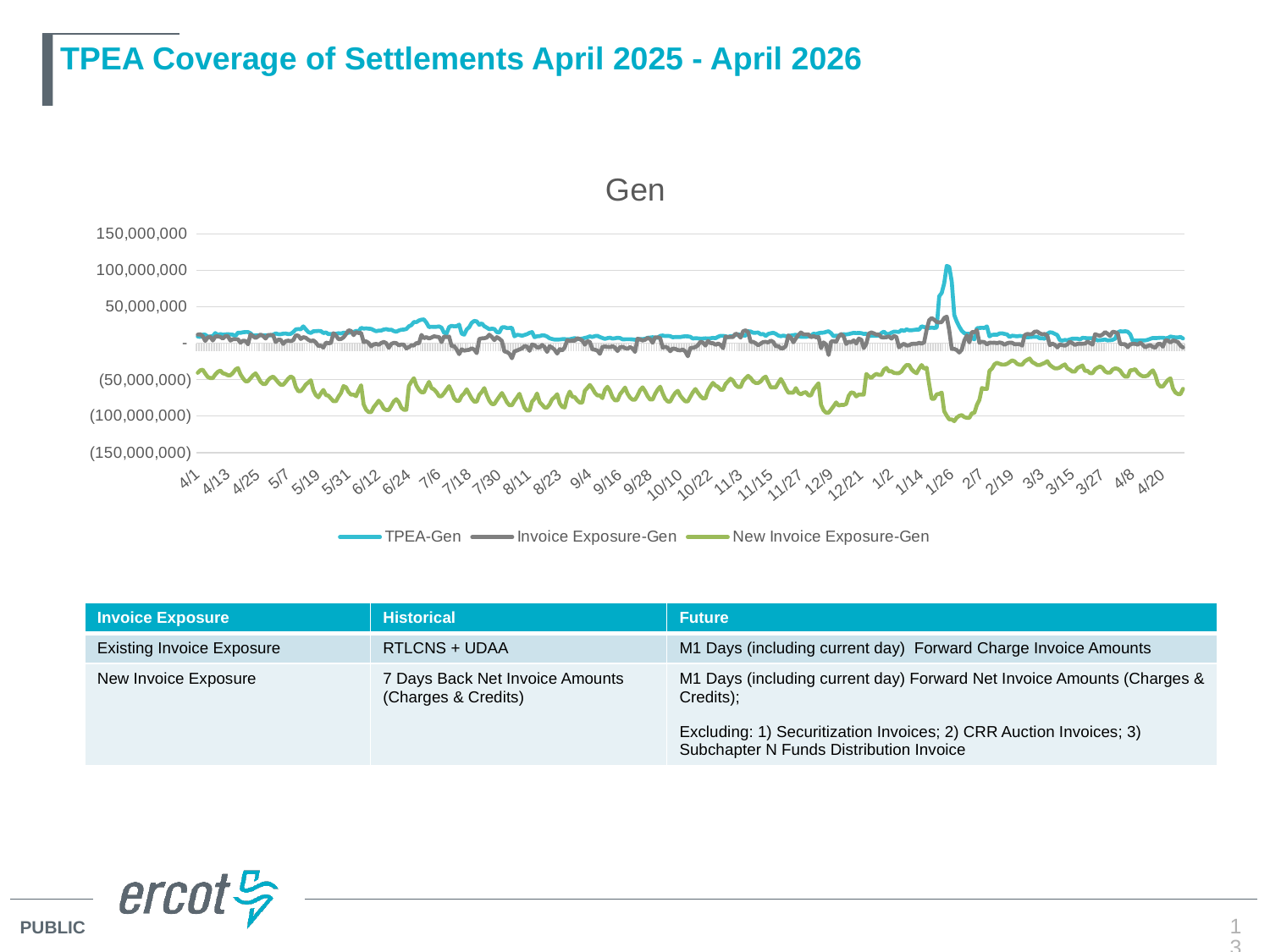
In the Gen chart, which series reaches the highest value over the period? TPEA-Gen What is the highest value shown on the vertical axis of the Gen chart? 150,000,000 In the Gen chart, is the peak value of TPEA-Gen around 1/26 greater or less than 50,000,000? greater In the Gen chart, is the value of New Invoice Exposure-Gen on 4/1 greater or less than (100,000,000)? greater How many series does the legend of the Gen chart list? 3 What is the title of the chart on the slide? Gen In the Gen chart, does New Invoice Exposure-Gen rise or fall between 12/9 and 1/14? Rise In the Gen chart, which series is higher around 1/26: TPEA-Gen or New Invoice Exposure-Gen? TPEA-Gen In the Gen chart, which series stays lowest throughout the period? New Invoice Exposure-Gen Which series in the Gen chart is drawn in green? New Invoice Exposure-Gen What kind of chart is shown on the slide? Line chart